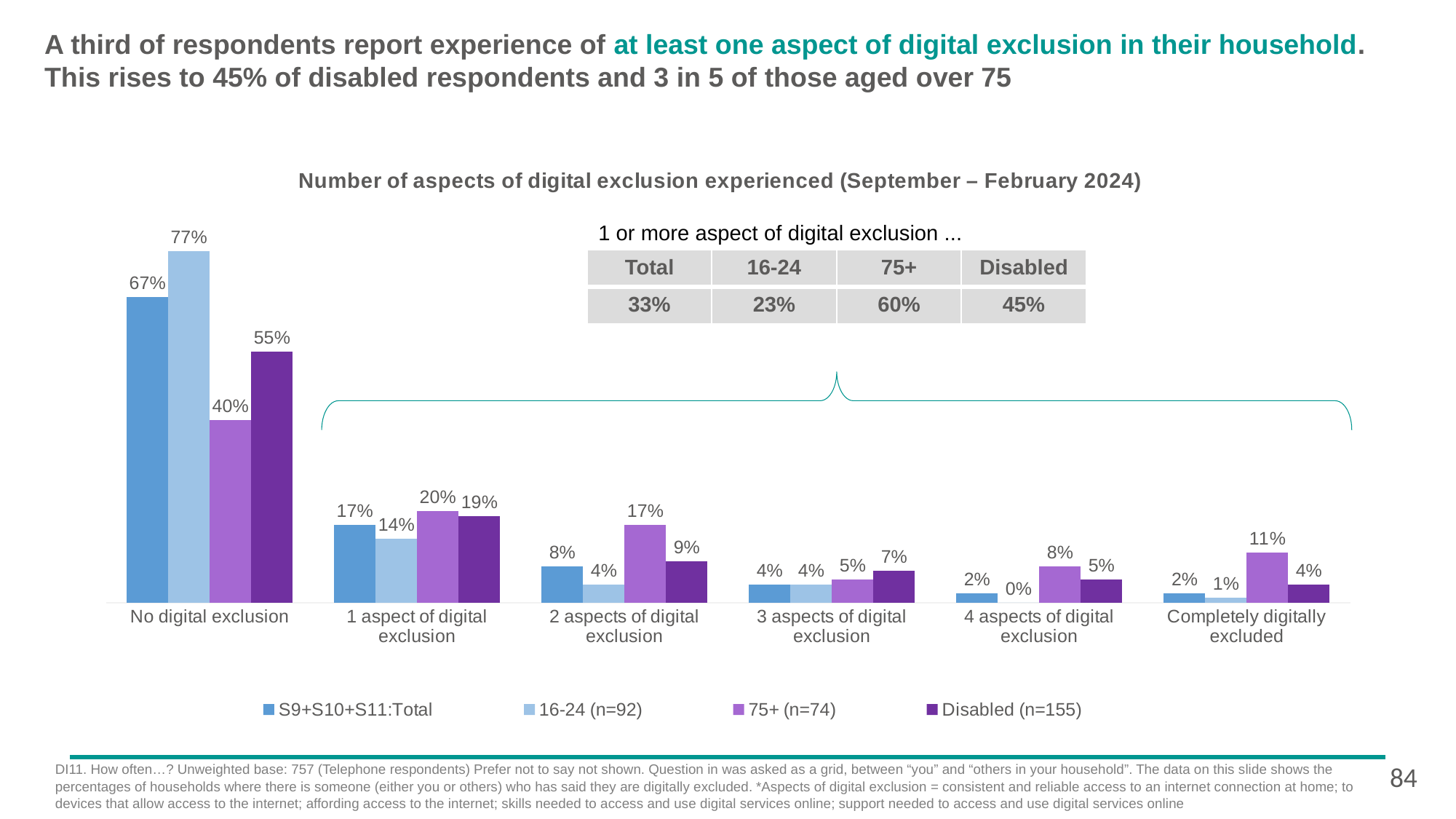
What is the value for the 75+ (n=74) series in the '2 aspects of digital exclusion' category? 17% How many series does the chart legend list? 4 What is the value for the 16-24 (n=92) series in the 'No digital exclusion' category? 77% What is the value for the Disabled (n=155) series in the 'Completely digitally excluded' category? 4% What is the difference between the S9+S10+S11:Total and 75+ (n=74) values in the 'No digital exclusion' category? 27% Do the values for the S9+S10+S11:Total series rise or fall from 'No digital exclusion' to '4 aspects of digital exclusion'? Fall Which series has the lowest value in the '4 aspects of digital exclusion' category? 16-24 (n=92) Which series has the highest value in the 'No digital exclusion' category? 16-24 (n=92) What kind of chart is shown on the slide? Bar chart In the '1 aspect of digital exclusion' category, which is larger: the 75+ (n=74) value or the 16-24 (n=92) value? 75+ (n=74) How many categories are shown on the x axis of the chart? 6 What is the title of the chart? Number of aspects of digital exclusion experienced (September – February 2024)